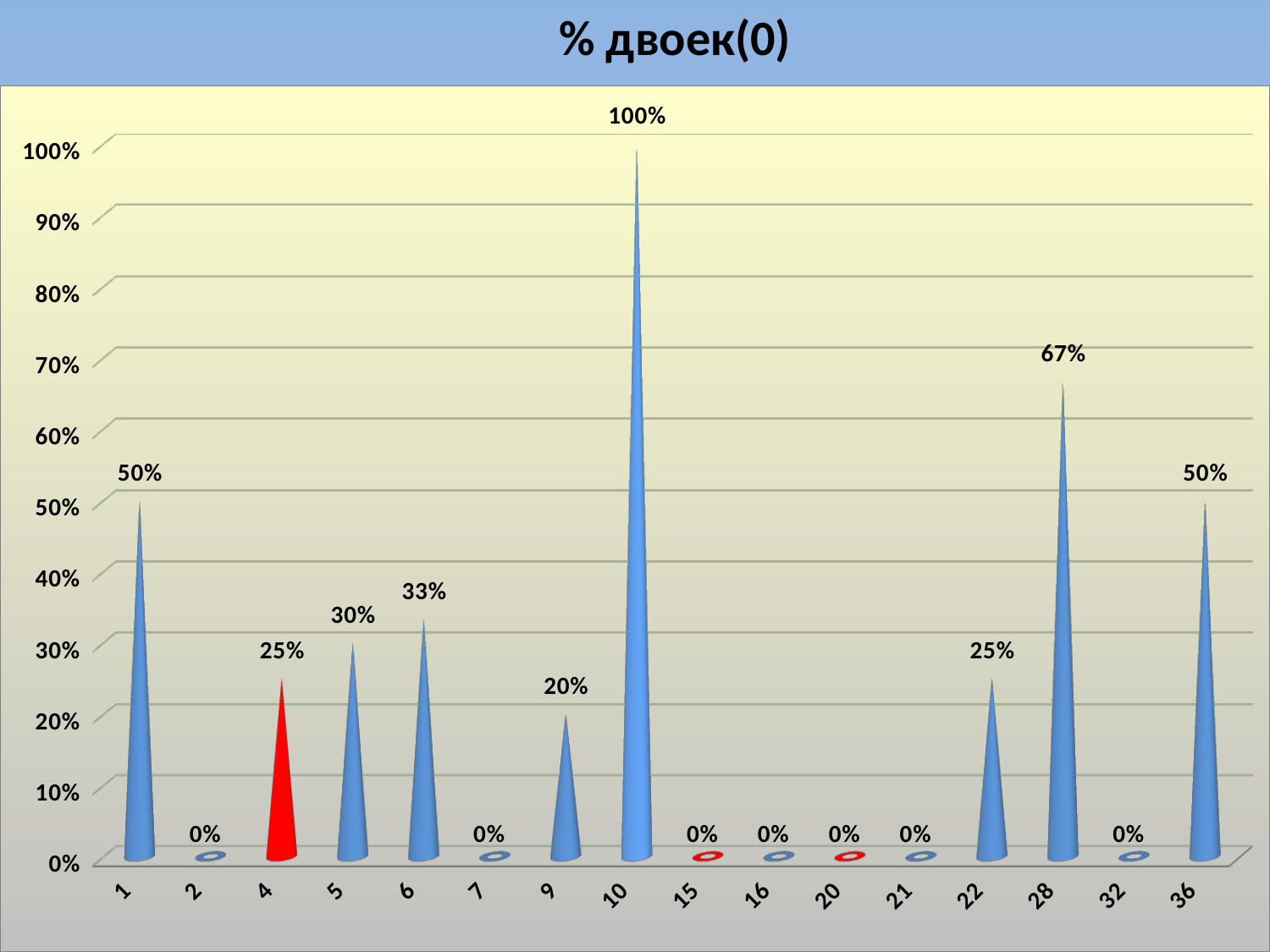
What is the difference between the values for categories 1 and 4? 25% What is the value for category 28? 67% What is the value for category 9? 20% What is the value for category 10? 100% Which is larger, the value for category 5 or the value for category 6? 6 What is the value for category 6? 33% What is the difference between the values for categories 10 and 28? 33% What kind of chart is shown on the slide? bar chart What is the title of the chart? % двоек(0) Which category has the highest value? 10 Which is larger, the value for category 36 or the value for category 22? 36 How many categories are shown on the x axis? 16